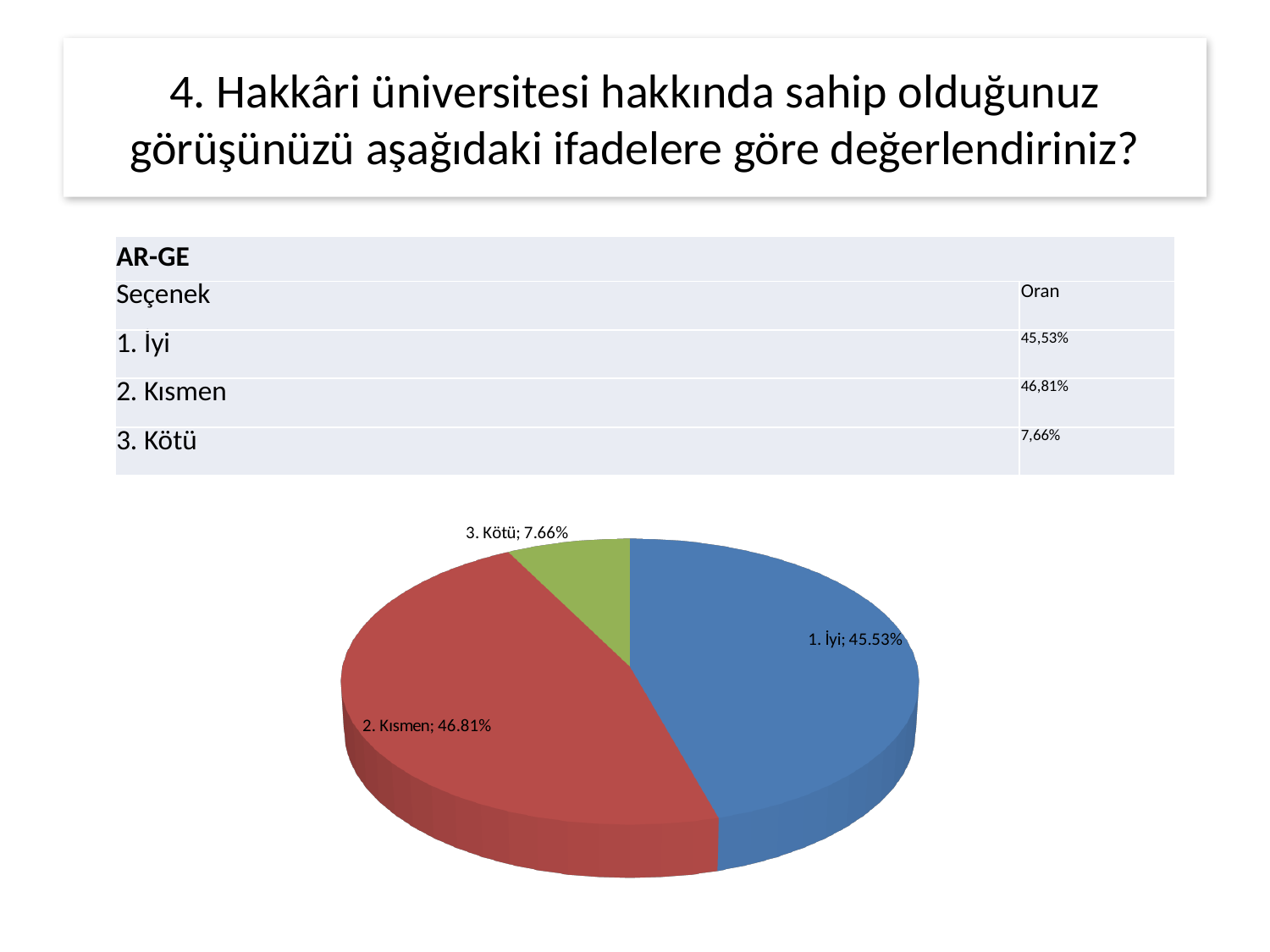
What is the value shown for the slice "1. İyi" in the pie chart? 45.53% What is the value shown for the slice "3. Kötü" in the pie chart? 7.66% What is the difference between the values for "2. Kısmen" and "1. İyi" in the pie chart? 1.28% What share of the pie does the "3. Kötü" slice represent? 7.66% Which is larger in the pie chart: "1. İyi" or "3. Kötü"? 1. İyi How many slices does the pie chart have? 3 Which slice of the pie chart has the smallest value? 3. Kötü What colour is the "2. Kısmen" slice in the pie chart? red What is the difference between the values for "1. İyi" and "3. Kötü" in the pie chart? 37.87% What is the value shown for the slice "2. Kısmen" in the pie chart? 46.81% Which slice of the pie chart has the largest value? 2. Kısmen What kind of chart is shown on the slide? pie chart